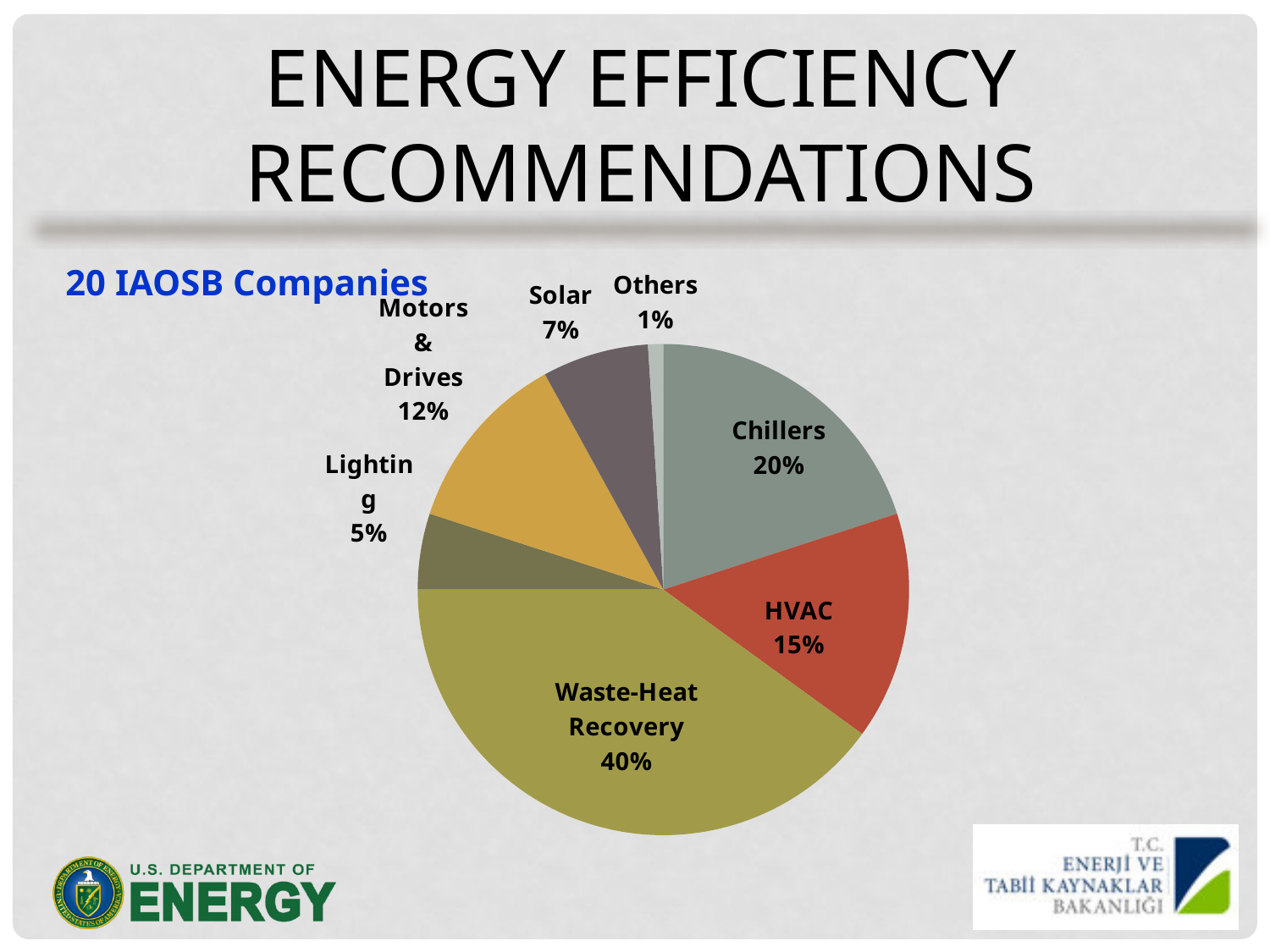
What share of the pie does Waste-Heat Recovery have? 40% What is the value shown for HVAC? 15% What kind of chart is shown on the slide? pie chart How many slices does the pie chart have? 7 What is the difference between the Chillers and HVAC shares? 5% What is the value shown for Solar? 7% What is the label shown above the pie chart in blue text? 20 IAOSB Companies Which category has the smallest slice of the pie? Others Which is larger, the share for Lighting or the share for Solar? Solar What is the value shown for Motors & Drives? 12% What is the value shown for Chillers? 20% Which category has the largest slice of the pie? Waste-Heat Recovery